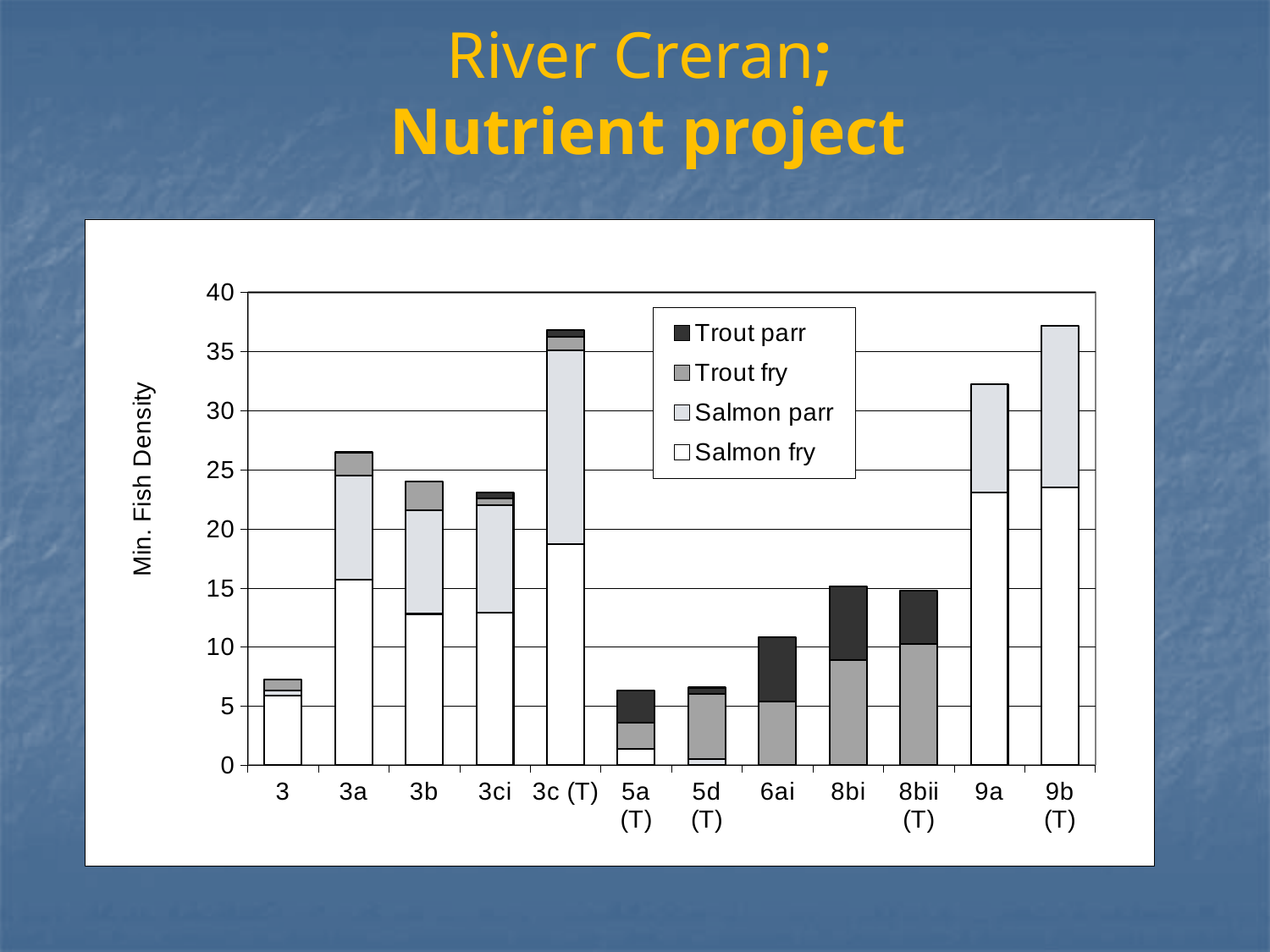
How many site categories are shown along the x axis? 12 Is the total value for site 9a greater or less than 30? greater Which series are listed in the legend? Trout parr, Trout fry, Salmon parr, Salmon fry What is the label on the vertical axis? Min. Fish Density How many series does the legend list? 4 What kind of chart is shown on the slide? Stacked bar chart Is the total value for site 3c (T) greater or less than 35? greater Is the total value for site 3 greater or less than 10? less Which site has the larger total, 3b or 6ai? 3b Which site has the larger total, 9a or 3a? 9a